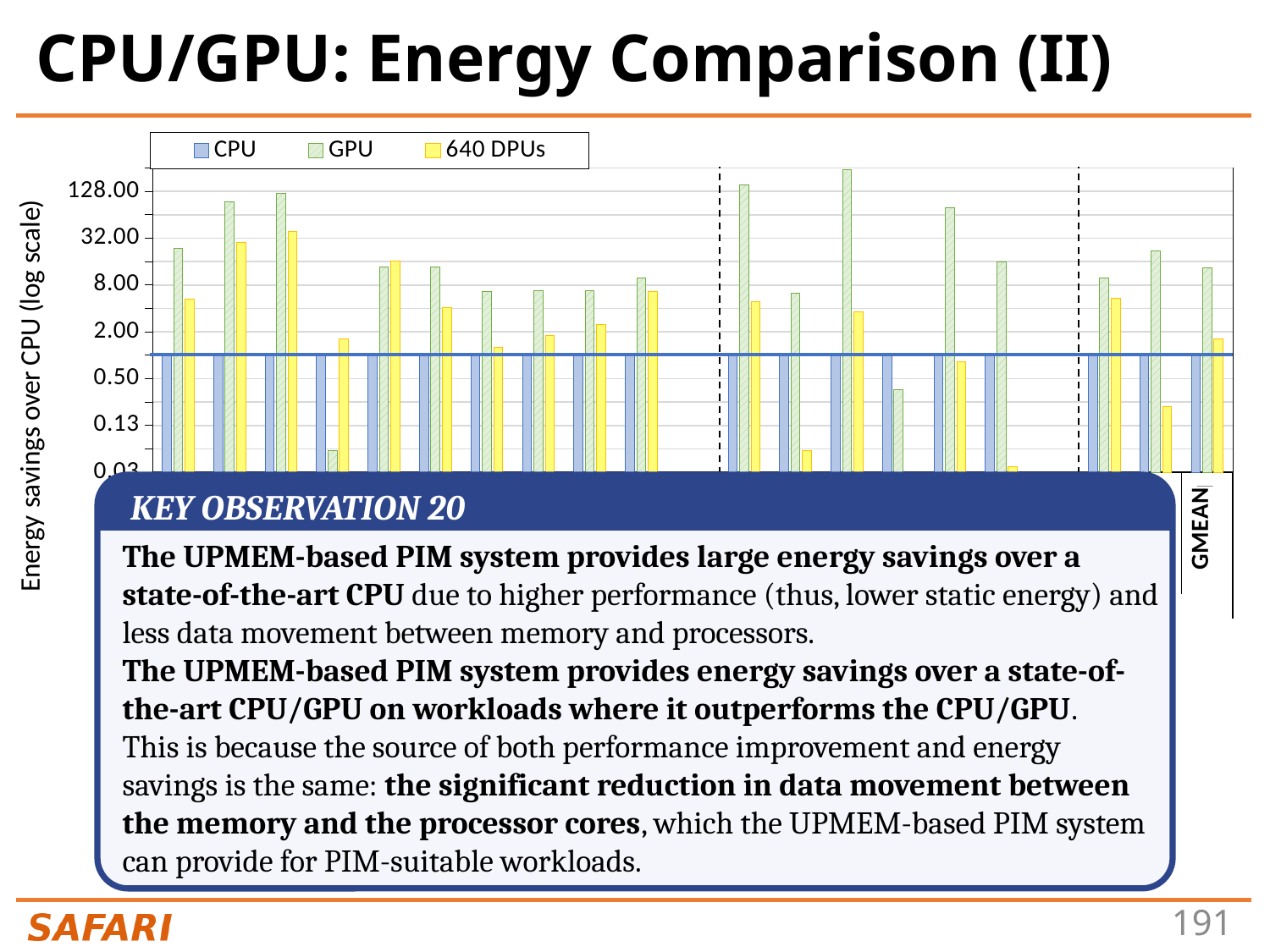
What are the three series named in the chart legend? CPU, GPU, 640 DPUs What is the label of the chart's y axis? Energy savings over CPU (log scale) How many series does the chart legend list? 3 For the GMEAN category, is the 640 DPUs value greater or less than 8.00? less For the GMEAN category, is the 640 DPUs value greater or less than 0.50? greater What kind of chart is shown on the slide? bar chart For the GMEAN category, is the GPU value greater or less than 8.00? greater For the GMEAN category, which series has the larger value, GPU or 640 DPUs? GPU For the GMEAN category, which series has the smallest value? CPU